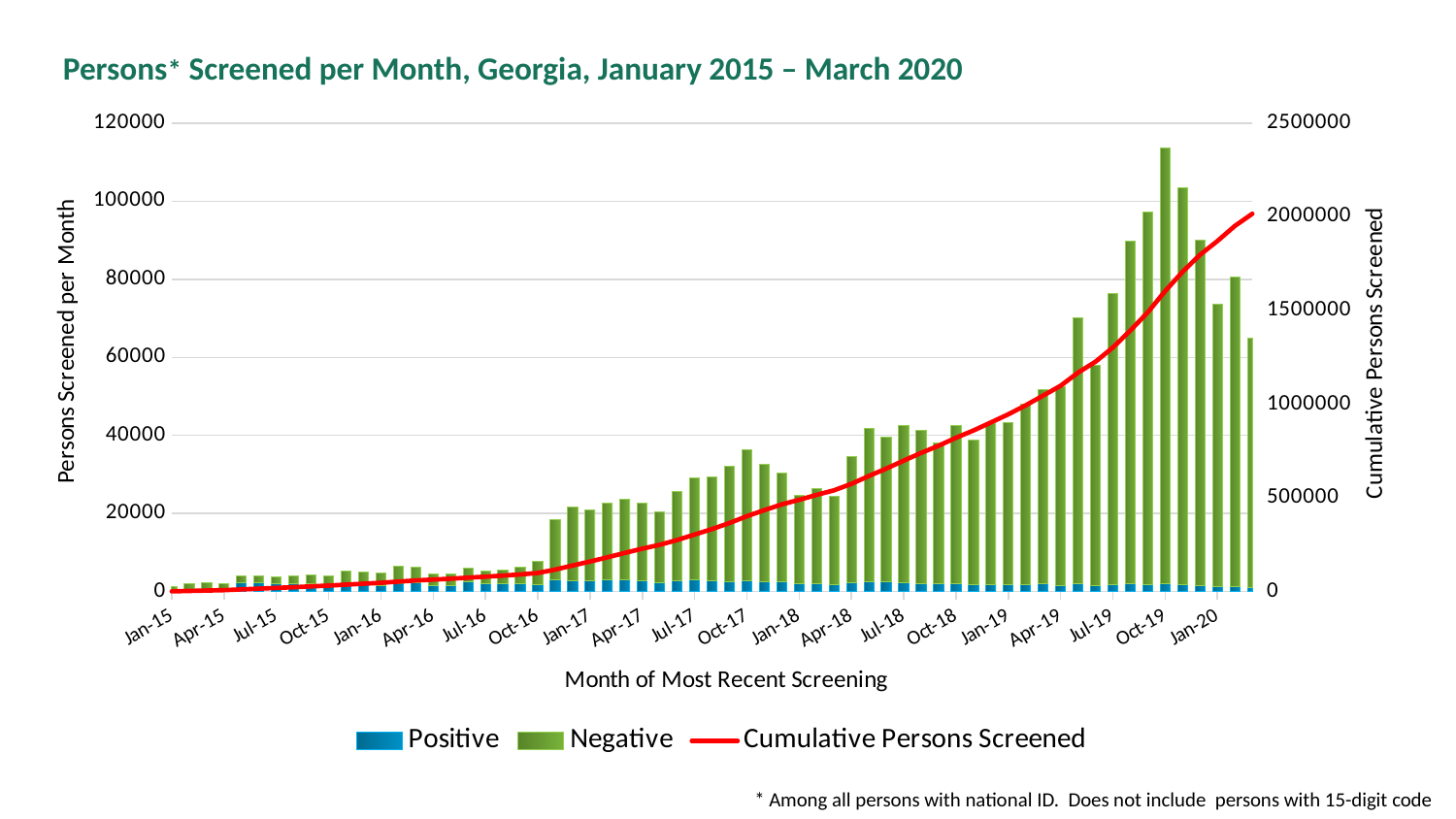
Is the Cumulative Persons Screened value at Jan-17 greater or less than 500000? less Which month has the taller bar, Jan-18 or Jan-19? Jan-19 How many series does the legend list? 3 Which series is plotted as the red line? Cumulative Persons Screened Does the Cumulative Persons Screened line rise or fall from Jan-15 to the end of the chart? Rises What is the title of the chart? Persons* Screened per Month, Georgia, January 2015 – March 2020 Is the Cumulative Persons Screened value at Jan-19 greater or less than 1000000? less Is the value of the tallest monthly bar greater or less than 100000? greater Which month has the taller bar, Jan-16 or Jan-17? Jan-17 What kind of chart is shown on the slide? A stacked bar chart with a line